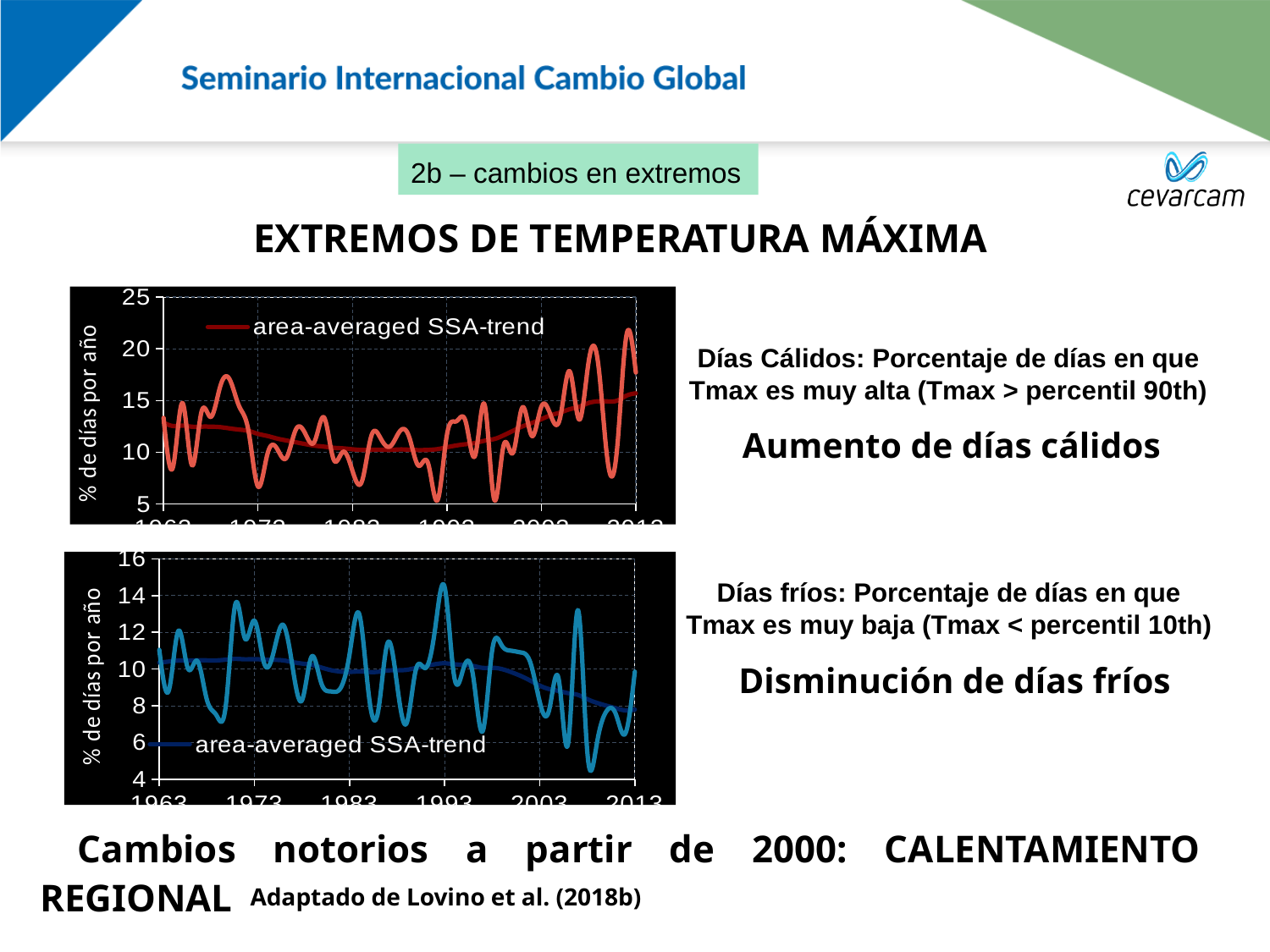
What kind of chart is the bottom chart on the slide? line chart In the top chart, does the area-averaged SSA-trend line rise or fall overall from 1963 to 2013? rise What is the maximum value shown on the y axis of the bottom chart? 16 In the top chart, is the highest peak of the red line (around 2011) greater or less than 20? greater What legend entry is shown in the bottom chart? area-averaged SSA-trend How many entries does the legend of the top chart list? 1 In the bottom chart, is the highest peak of the blue line (around 1993) greater or less than 12? greater In the bottom chart, is the value of the blue trend line at 2013 greater or less than 10? less In the bottom chart, does the area-averaged SSA-trend line rise or fall overall from 1963 to 2013? fall What kind of chart is the top chart on the slide? line chart What is the label of the y axis on the top chart? % de días por año